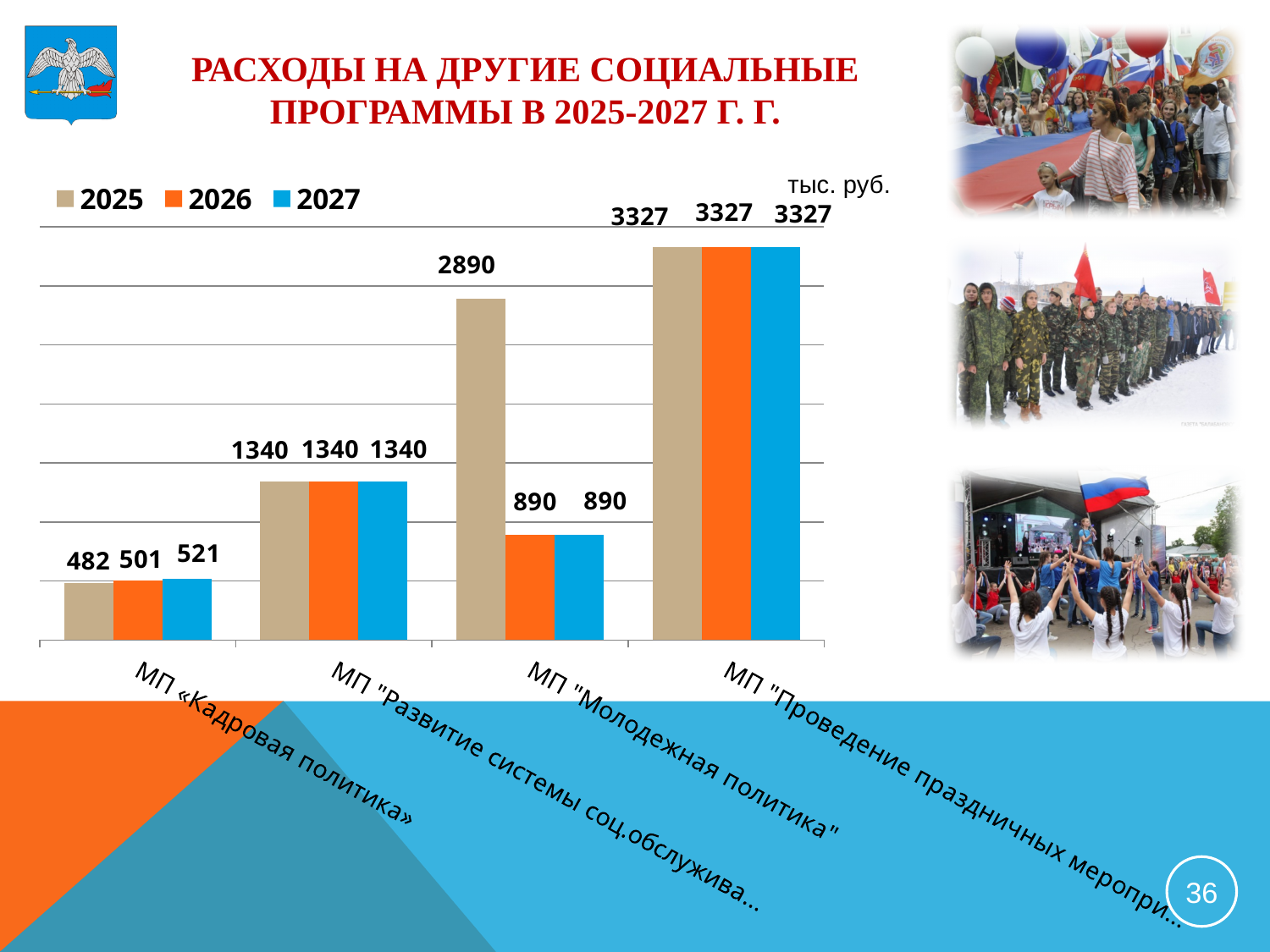
Which category has the highest value in 2025? МП "Проведение праздничных меропри..." What is the difference between the 2027 and 2025 values for МП «Кадровая политика»? 39 How many categories are shown on the x axis? 4 Which category has the lowest value in 2027? МП «Кадровая политика» What is the value for МП "Проведение праздничных меропри..." in 2027? 3327 How many series does the legend list? 3 What is the value for МП "Молодежная политика" in 2026? 890 What kind of chart is shown on the slide? Bar chart What is the difference between the 2025 and 2026 values for МП "Молодежная политика"? 2000 Which is larger: the 2025 value for МП "Молодежная политика" or the 2025 value for МП "Развитие системы соц.обслужива..."? МП "Молодежная политика" What is the value for МП "Развитие системы соц.обслужива..." in 2026? 1340 What is the value for МП «Кадровая политика» in 2025? 482